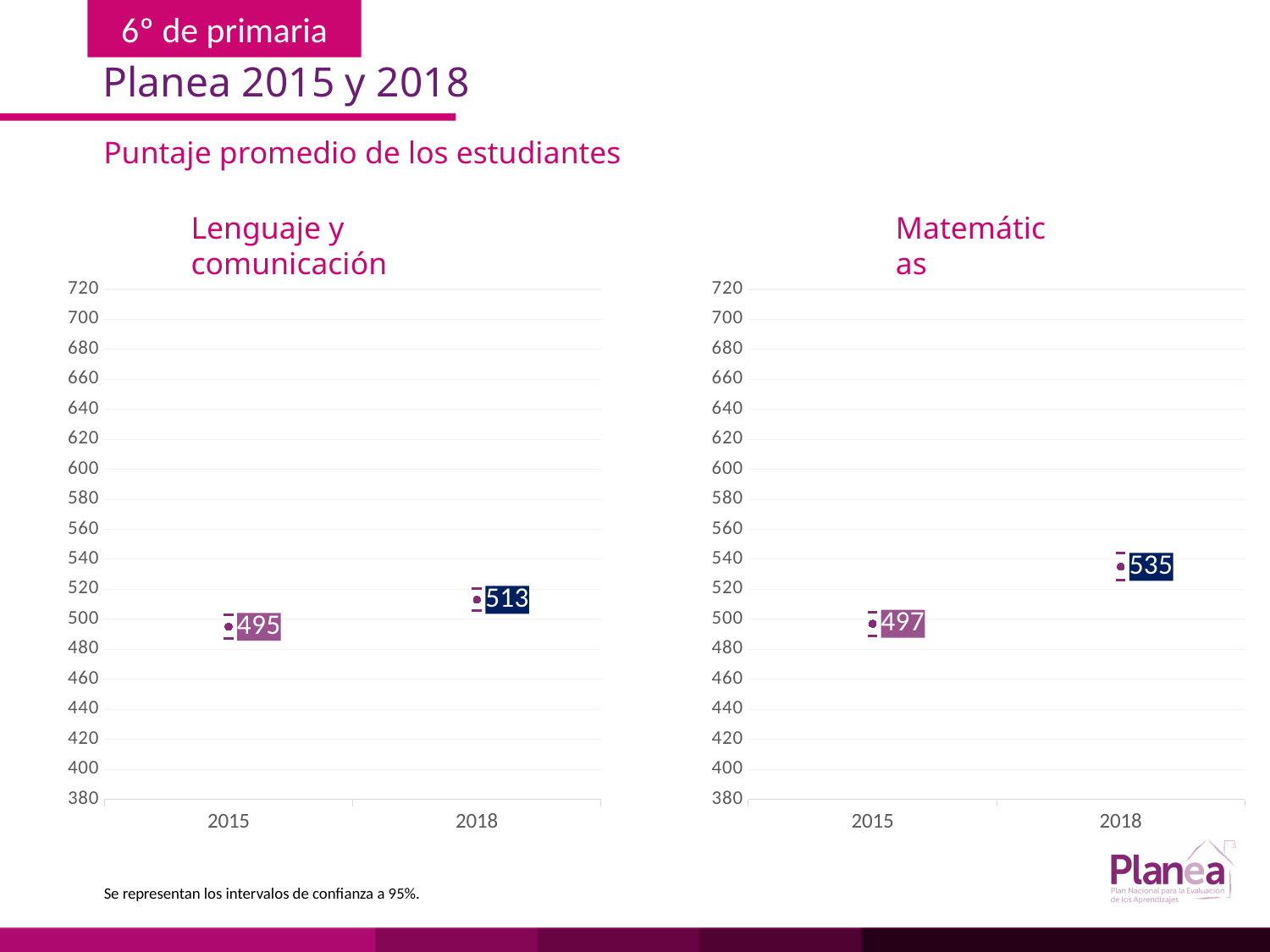
In the Lenguaje y comunicación chart, what is the difference between the 2018 and 2015 values? 18 In the Matemáticas chart, what is the difference between the 2018 and 2015 values? 38 In the Matemáticas chart, which year has the higher value? 2018 Which is larger: the 2018 value in the Lenguaje y comunicación chart or the 2018 value in the Matemáticas chart? Matemáticas 2018 (535) In the Matemáticas chart, do the values rise or fall from 2015 to 2018? rise What kind of chart is the Matemáticas chart? scatter chart with error bars In the Matemáticas chart, what is the value for 2018? 535 How many years are plotted on the x axis of the Lenguaje y comunicación chart? 2 In the Lenguaje y comunicación chart, what is the value for 2018? 513 In the Matemáticas chart, what is the value for 2015? 497 In the Lenguaje y comunicación chart, which year has the lower value? 2015 In the Lenguaje y comunicación chart, what is the value for 2015? 495